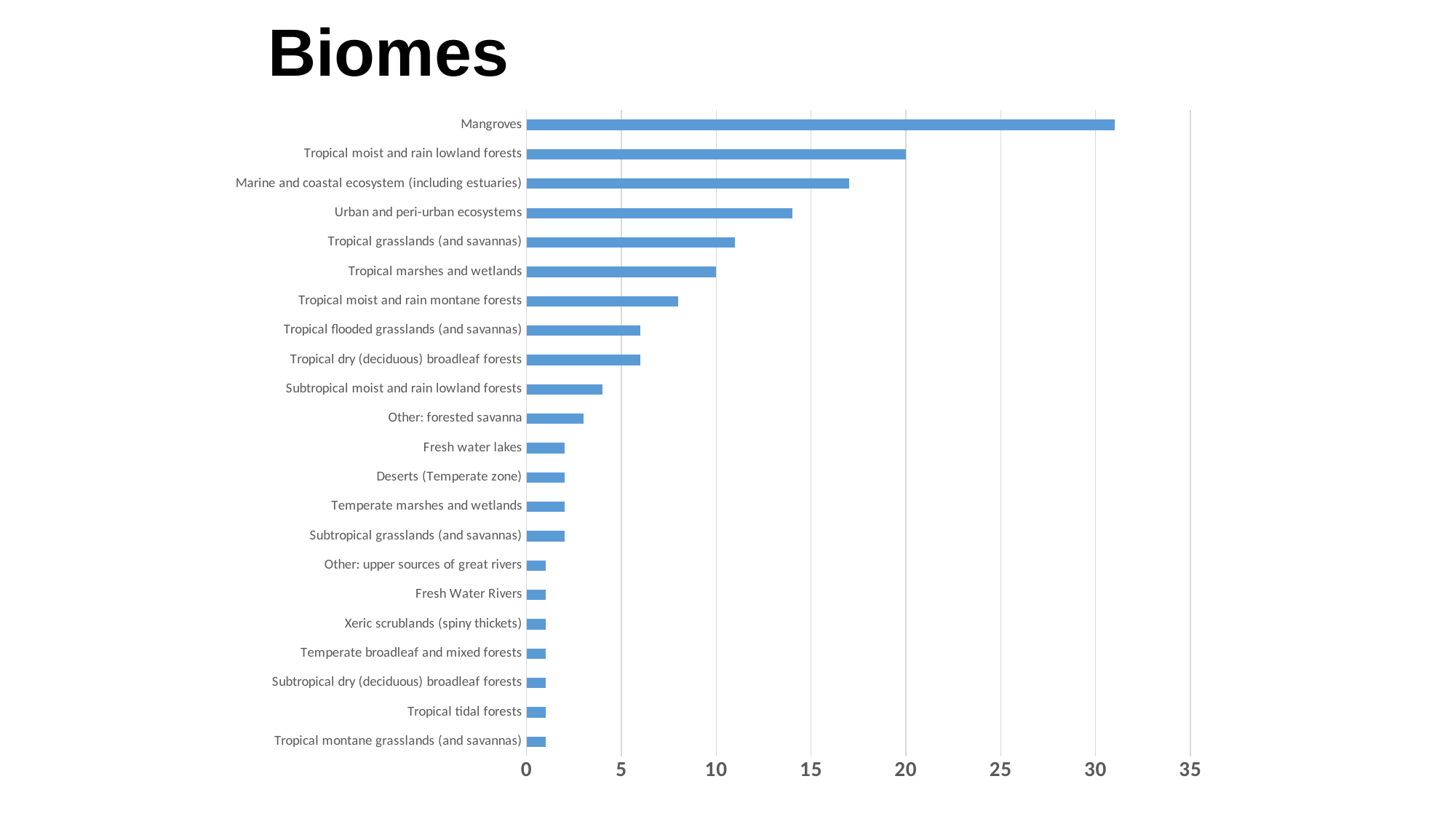
Is the value for Mangroves greater or less than 30? greater What kind of chart is shown on the slide? bar chart Do the bar values increase or decrease going from the top of the chart to the bottom? decrease Is the value for Subtropical moist and rain lowland forests greater or less than 5? less What is the title of the chart? Biomes Which has a larger value, Mangroves or Tropical moist and rain lowland forests? Mangroves Which biome has the highest value? Mangroves What is the value for Tropical marshes and wetlands? 10 What is the value for Tropical moist and rain lowland forests? 20 Is the value for Marine and coastal ecosystem (including estuaries) greater or less than 15? greater How many biome categories are plotted in the chart? 22